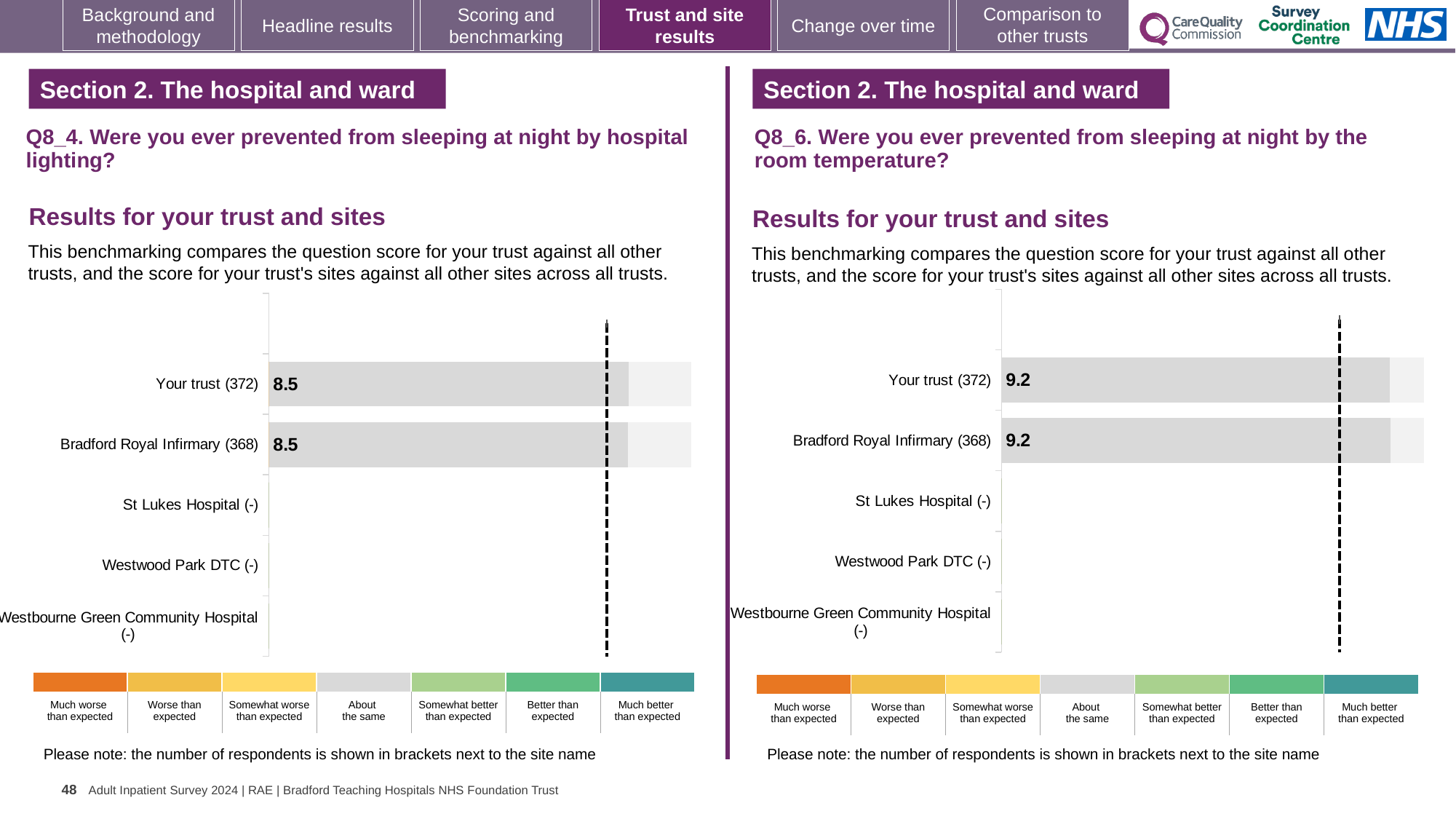
On the left chart (Q8_4, hospital lighting), what is the score for Your trust? 8.5 How many site/trust categories are listed on the left chart (Q8_4, hospital lighting)? 5 On the right chart (Q8_6, room temperature), what is the difference between the scores for Your trust and Bradford Royal Infirmary? 0 On the right chart (Q8_6, room temperature), how many respondents are shown in brackets for Bradford Royal Infirmary? 368 On the right chart (Q8_6, room temperature), what is the score for Your trust? 9.2 On the right chart (Q8_6, room temperature), which site is listed last on the vertical axis? Westbourne Green Community Hospital (-) On the left chart (Q8_4, hospital lighting), what is the score for Bradford Royal Infirmary? 8.5 On the right chart (Q8_6, room temperature), what is the score for Bradford Royal Infirmary? 9.2 How many site/trust categories are listed on the right chart (Q8_6, room temperature)? 5 On the left chart (Q8_4, hospital lighting), how many respondents are shown in brackets for Your trust? 372 What kind of chart is used on the left (Q8_4, hospital lighting)? Bar chart On the left chart (Q8_4, hospital lighting), what is the difference between the scores for Your trust and Bradford Royal Infirmary? 0